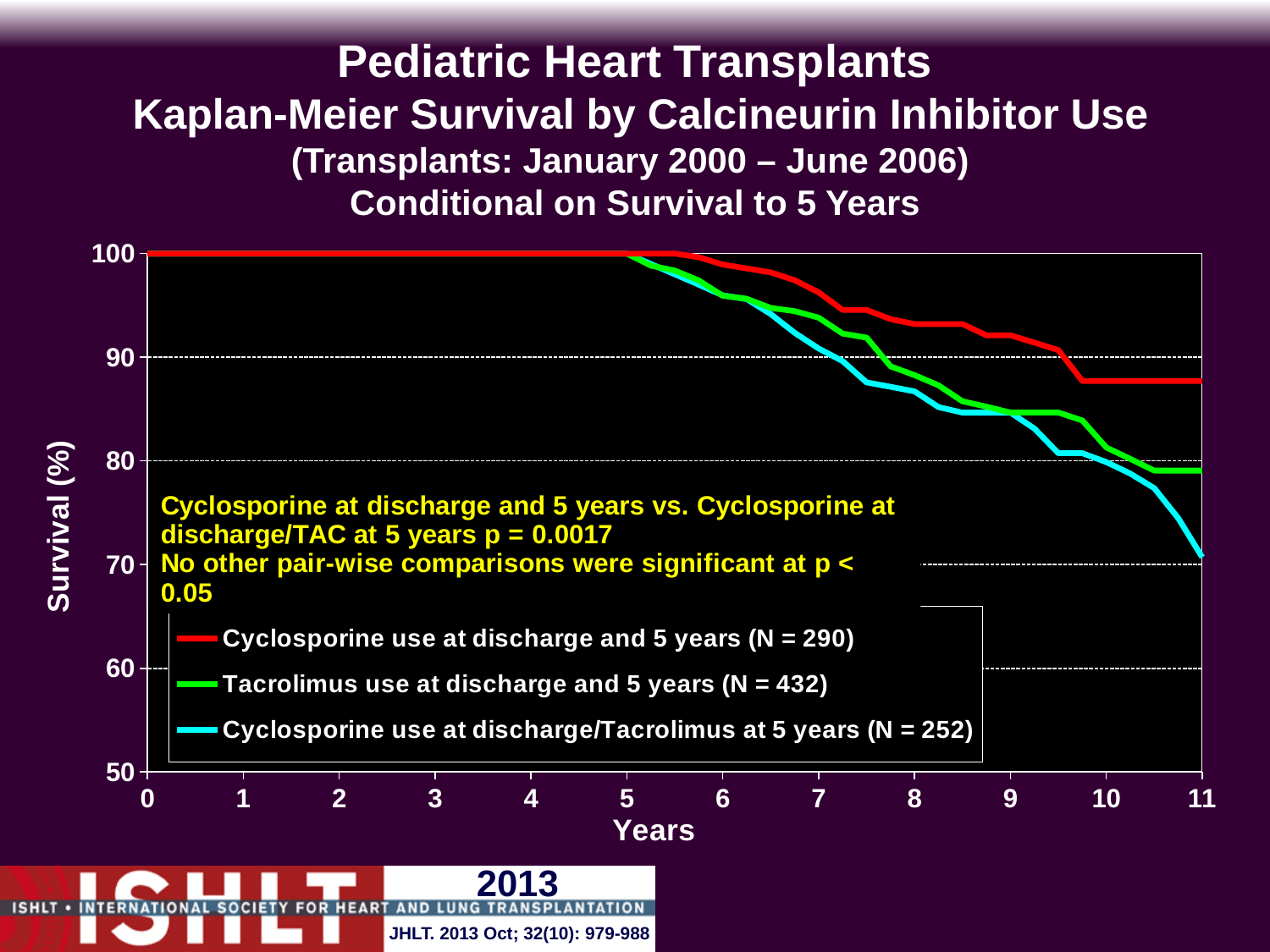
Is the survival for Cyclosporine use at discharge/Tacrolimus at 5 years at 11 years greater or less than 80? less At 11 years, is survival higher for the Cyclosporine use at discharge and 5 years group or the Cyclosporine use at discharge/Tacrolimus at 5 years group? Cyclosporine use at discharge and 5 years What is the p-value given for Cyclosporine at discharge and 5 years vs. Cyclosporine at discharge/TAC at 5 years? 0.0017 Is the survival for Cyclosporine use at discharge/Tacrolimus at 5 years at 8 years greater or less than 90? less Which series has the highest survival at 11 years? Cyclosporine use at discharge and 5 years How many series does the legend list? 3 Do the survival curves rise or fall as years increase beyond 5? fall Which series has the lowest survival at 11 years? Cyclosporine use at discharge/Tacrolimus at 5 years Which series does the red line represent? Cyclosporine use at discharge and 5 years (N = 290) Is the survival for Cyclosporine use at discharge and 5 years at 11 years greater or less than 80? greater What kind of chart is shown on the slide? line chart